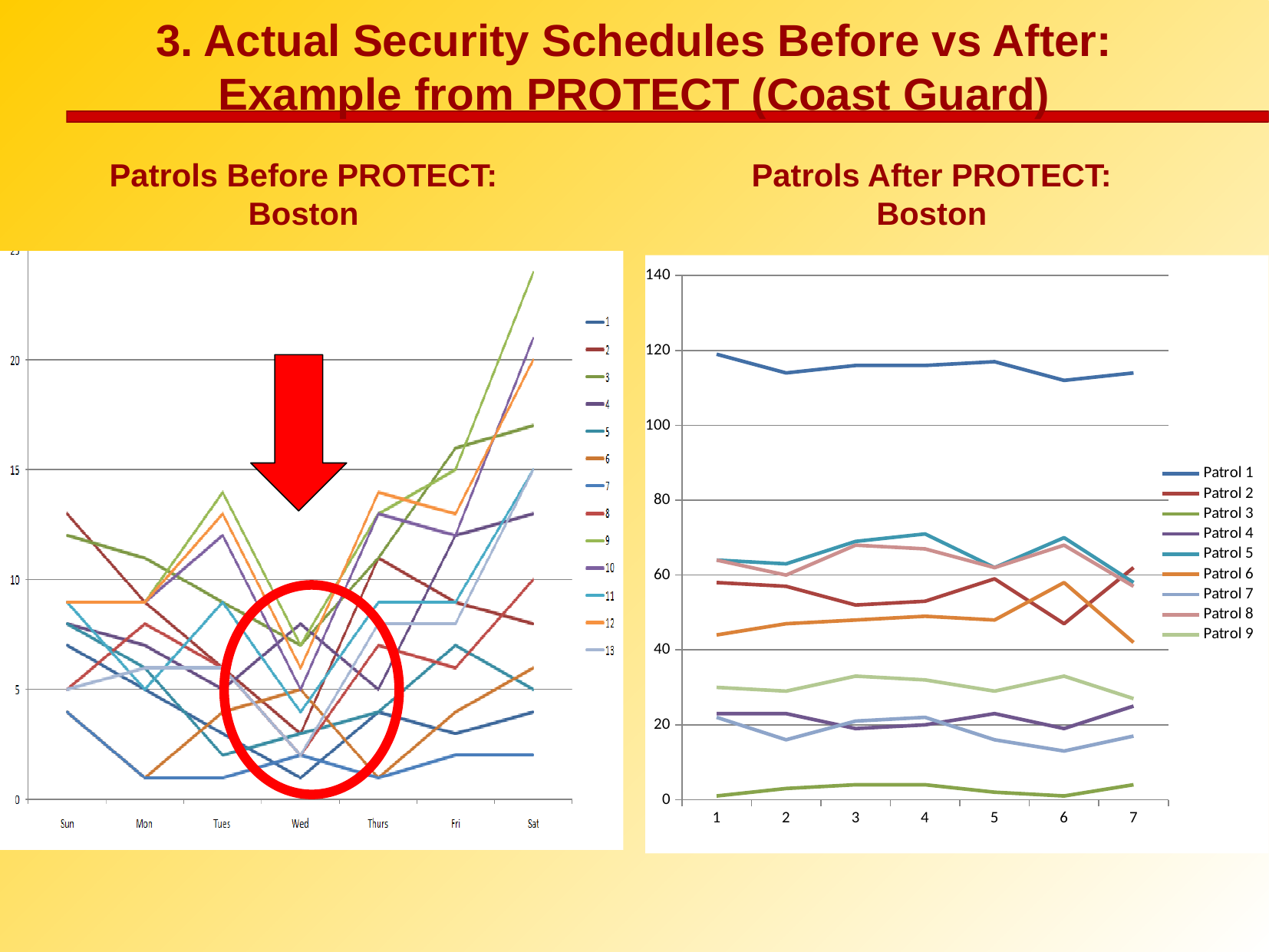
In the 'Patrols After PROTECT: Boston' chart, is the value for Patrol 9 at point 3 greater or less than 40? less In the 'Patrols After PROTECT: Boston' chart, how many points are on the x axis? 7 What kind of chart is the 'Patrols After PROTECT: Boston' chart? line chart In the 'Patrols Before PROTECT: Boston' chart, how many categories are on the x axis? 7 In the 'Patrols Before PROTECT: Boston' chart, is the value for series 9 on Sat greater or less than 20? greater What kind of chart is the 'Patrols Before PROTECT: Boston' chart? line chart In the 'Patrols After PROTECT: Boston' chart, which is larger at point 4: Patrol 1 or Patrol 9? Patrol 1 What is the first category on the x axis of the 'Patrols Before PROTECT: Boston' chart? Sun In the 'Patrols After PROTECT: Boston' chart, how many series does the legend list? 9 In the 'Patrols After PROTECT: Boston' chart, which patrol has the highest values across all points? Patrol 1 In the 'Patrols After PROTECT: Boston' chart, is the value for Patrol 1 at point 1 greater or less than 100? greater In the 'Patrols Before PROTECT: Boston' chart, how many series does the legend list? 13